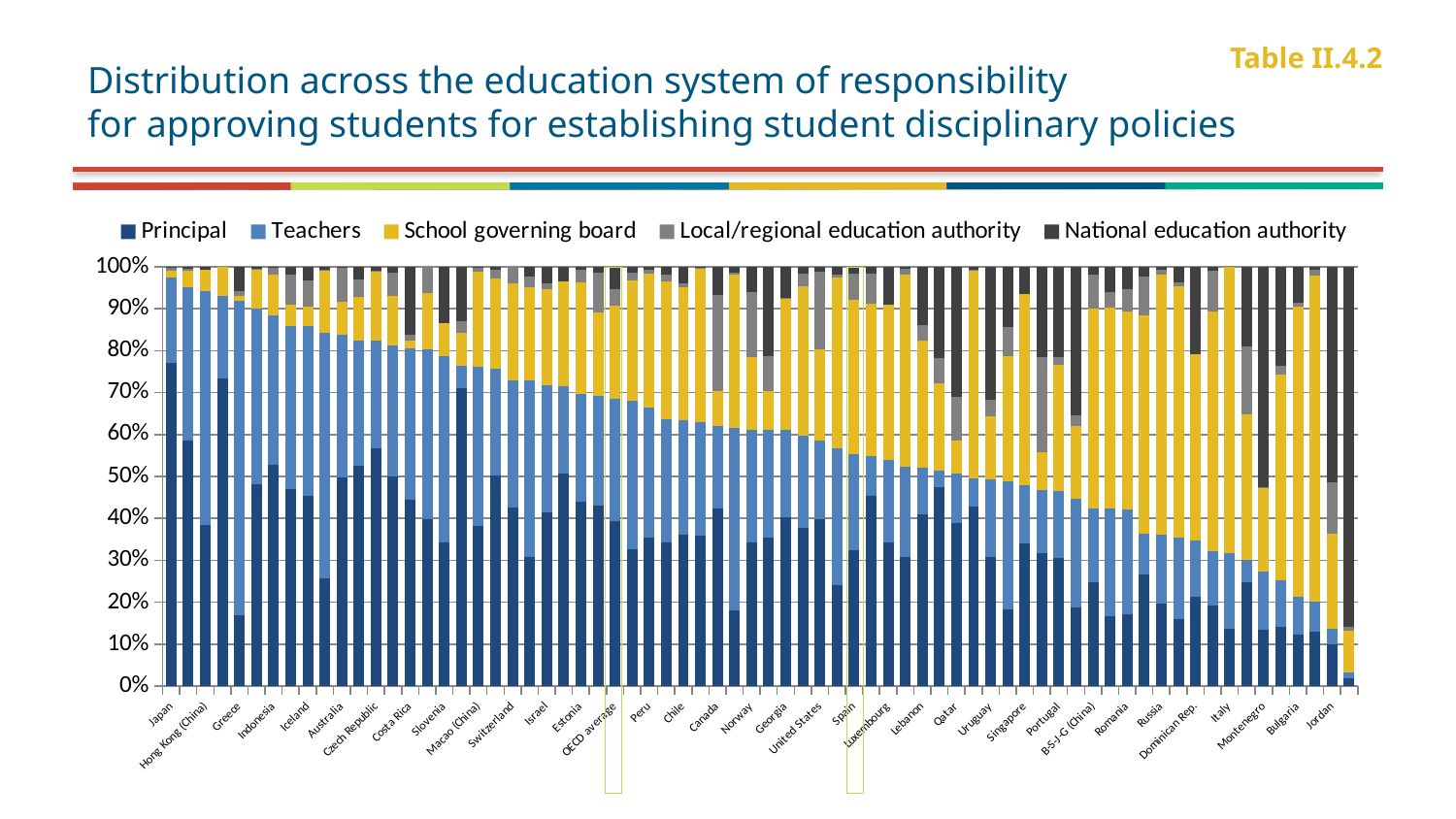
Is the Principal value for Japan greater or less than 70%? greater Which series is listed last in the legend? National education authority What kind of chart is shown on the slide? Stacked bar chart Which series is listed first in the legend? Principal Is the Principal value for Japan greater or less than 90%? less Does the Principal share generally rise or fall moving from left to right across the countries? fall How many series does the legend list? 5